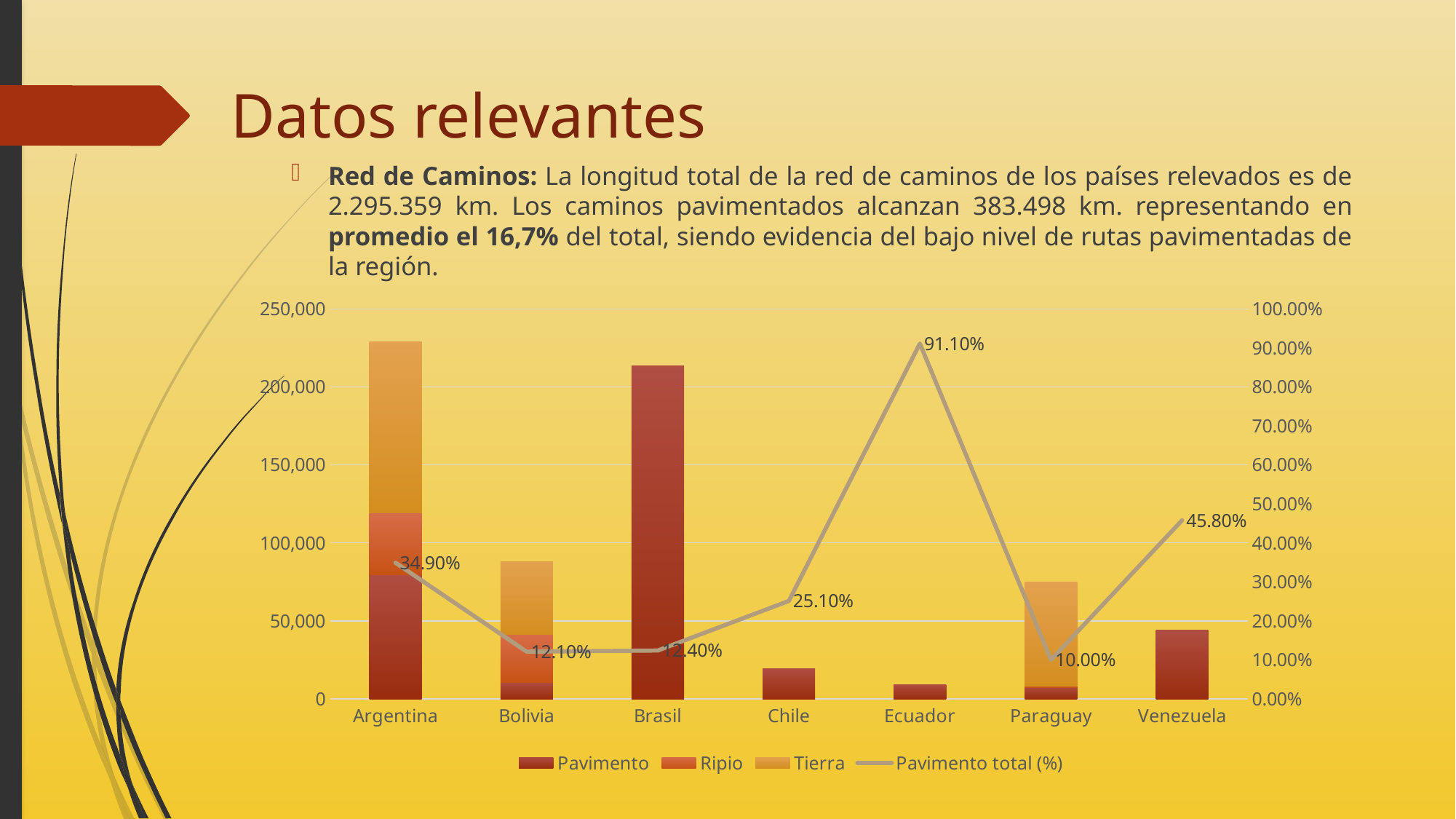
What kind of chart is shown on the slide? Stacked bar chart with a line Which has a higher Pavimento total (%), Venezuela or Argentina? Venezuela What is the Pavimento total (%) value for Ecuador? 91.10% Is the total stacked bar value for Chile greater or less than 50,000? less How many series does the legend list? 4 Which country has the lowest Pavimento total (%)? Paraguay What is the Pavimento total (%) value for Argentina? 34.90% What is the difference between the Pavimento total (%) of Ecuador and Paraguay? 81.10% Which country has the highest Pavimento total (%)? Ecuador What is the Pavimento total (%) value for Venezuela? 45.80% How many countries are shown on the x axis? 7 Is the total stacked bar value for Argentina greater or less than 200,000? greater